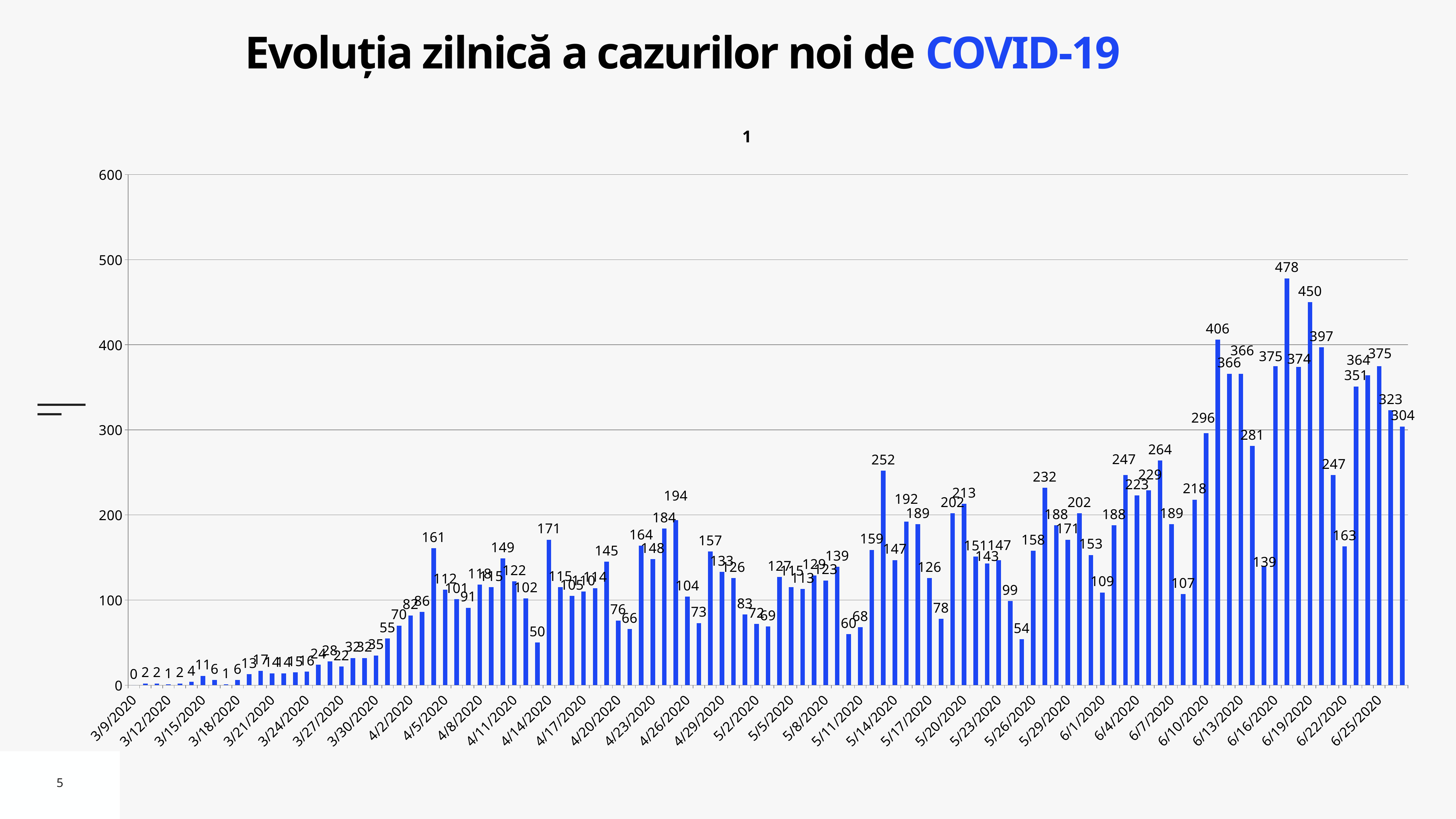
Which is larger, the bar labelled 406 or the bar labelled 397? 406 What is the difference between the two highest values in the chart, 478 and 450? 28 Is the tallest bar in the chart greater or less than 500? less What is the difference between the highest value (478) and the value of the last bar (304)? 174 What is the lowest daily value shown in the chart? 0 How many bars in the chart have a value above 400? 3 Do the daily values generally rise or fall from March to June along the x axis? rise What is the value of the last bar on the right of the chart? 304 What is the highest daily value shown in the chart? 478 What is the title of the slide? Evoluția zilnică a cazurilor noi de COVID-19 What kind of chart is shown on the slide? bar chart What is the value of the first bar on the left of the chart (3/9/2020)? 0